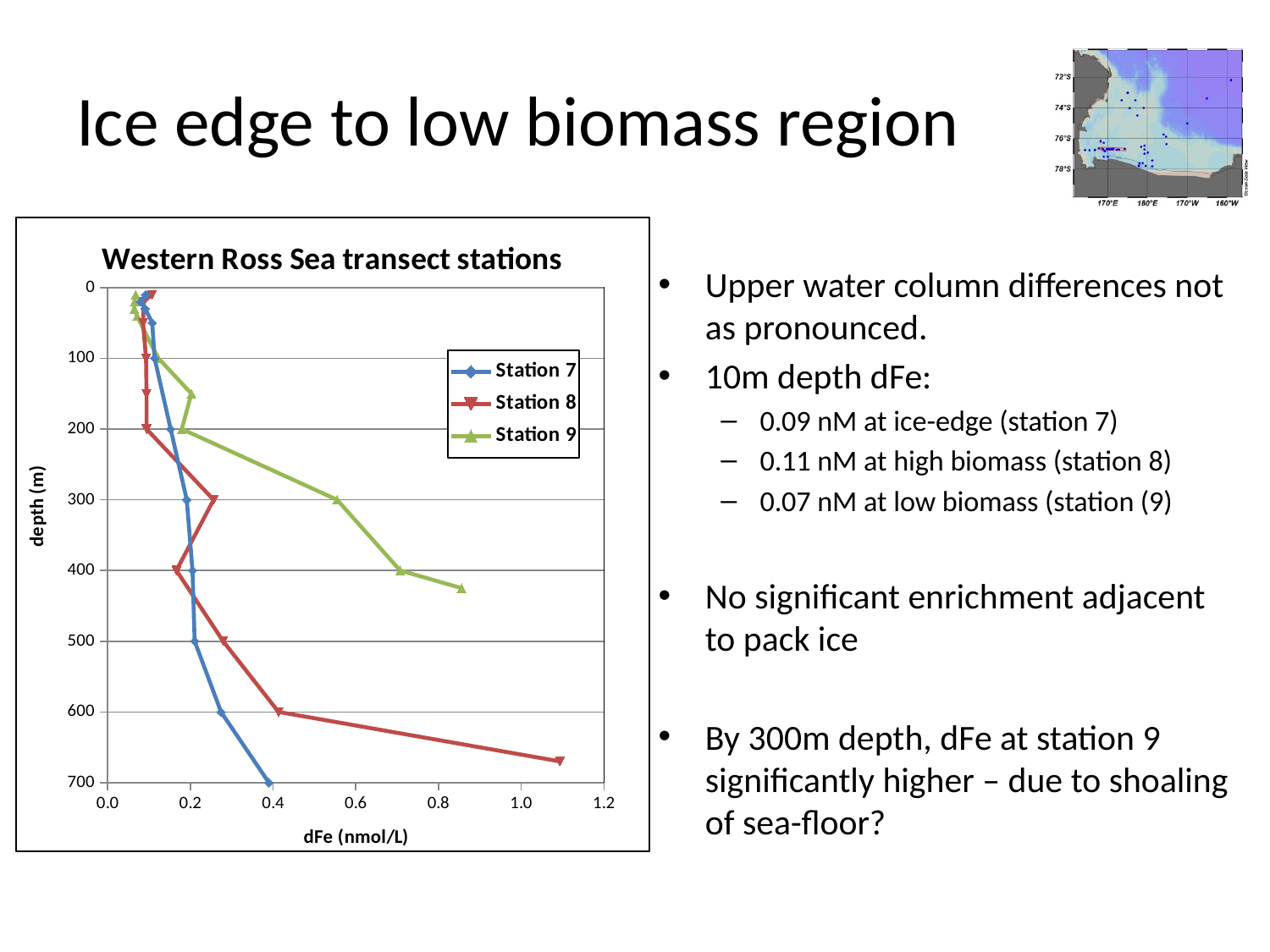
Is the dFe value for Station 9 at 300 m depth greater or less than 0.4? greater Is the dFe value for Station 9 at 400 m depth greater or less than 0.6? greater How many series does the chart legend list? 3 Is the dFe value for Station 7 at 500 m depth greater or less than 0.4? less What kind of chart is shown on the slide? line chart For Station 7, does dFe generally increase or decrease as depth increases from 0 to 700 m? increase At 600 m depth, which station has the higher dFe value, Station 7 or Station 8? Station 8 What is the label of the horizontal axis of the chart? dFe (nmol/L) What is the title of the chart? Western Ross Sea transect stations At 300 m depth, which station has the higher dFe value, Station 7 or Station 9? Station 9 Which station reaches the highest dFe value plotted on the chart? Station 8